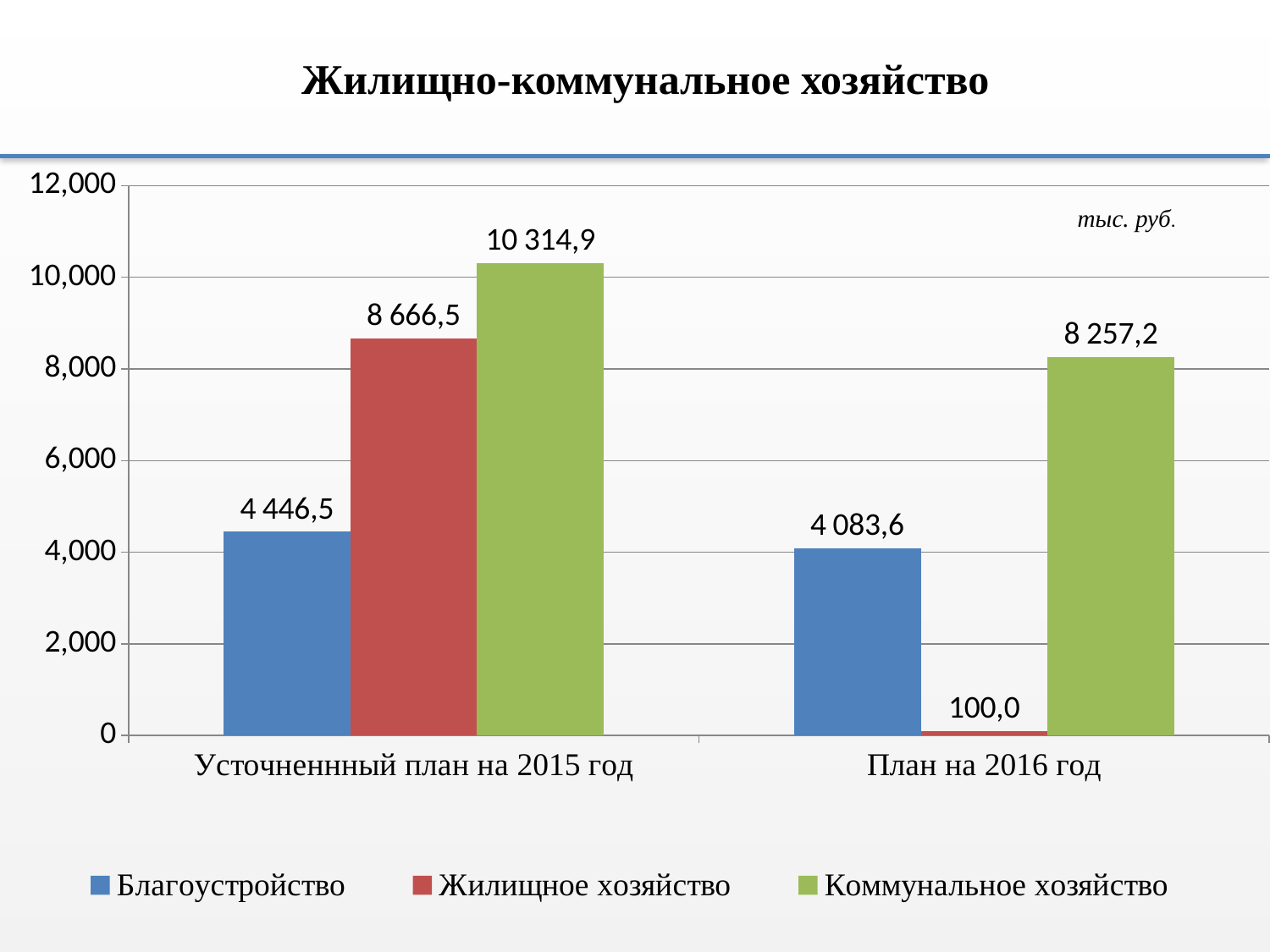
Is the value for Коммунальное хозяйство in Усточненнный план на 2015 год greater or less than 10,000? greater What is the difference between the Коммунальное хозяйство values for 2015 and 2016? 2 057,7 Which series has the highest value in Усточненнный план на 2015 год? Коммунальное хозяйство Which series has the lowest value in План на 2016 год? Жилищное хозяйство What kind of chart is shown on the slide? bar chart What is the value for Коммунальное хозяйство in План на 2016 год? 8 257,2 What is the value for Благоустройство in Усточненнный план на 2015 год? 4 446,5 How many categories are shown on the x axis? 2 Which is larger: Жилищное хозяйство in 2015 or Коммунальное хозяйство in 2016? Жилищное хозяйство in 2015 What is the difference between the Благоустройство values for 2015 and 2016? 362,9 What is the value for Жилищное хозяйство in План на 2016 год? 100,0 How many series does the legend list? 3